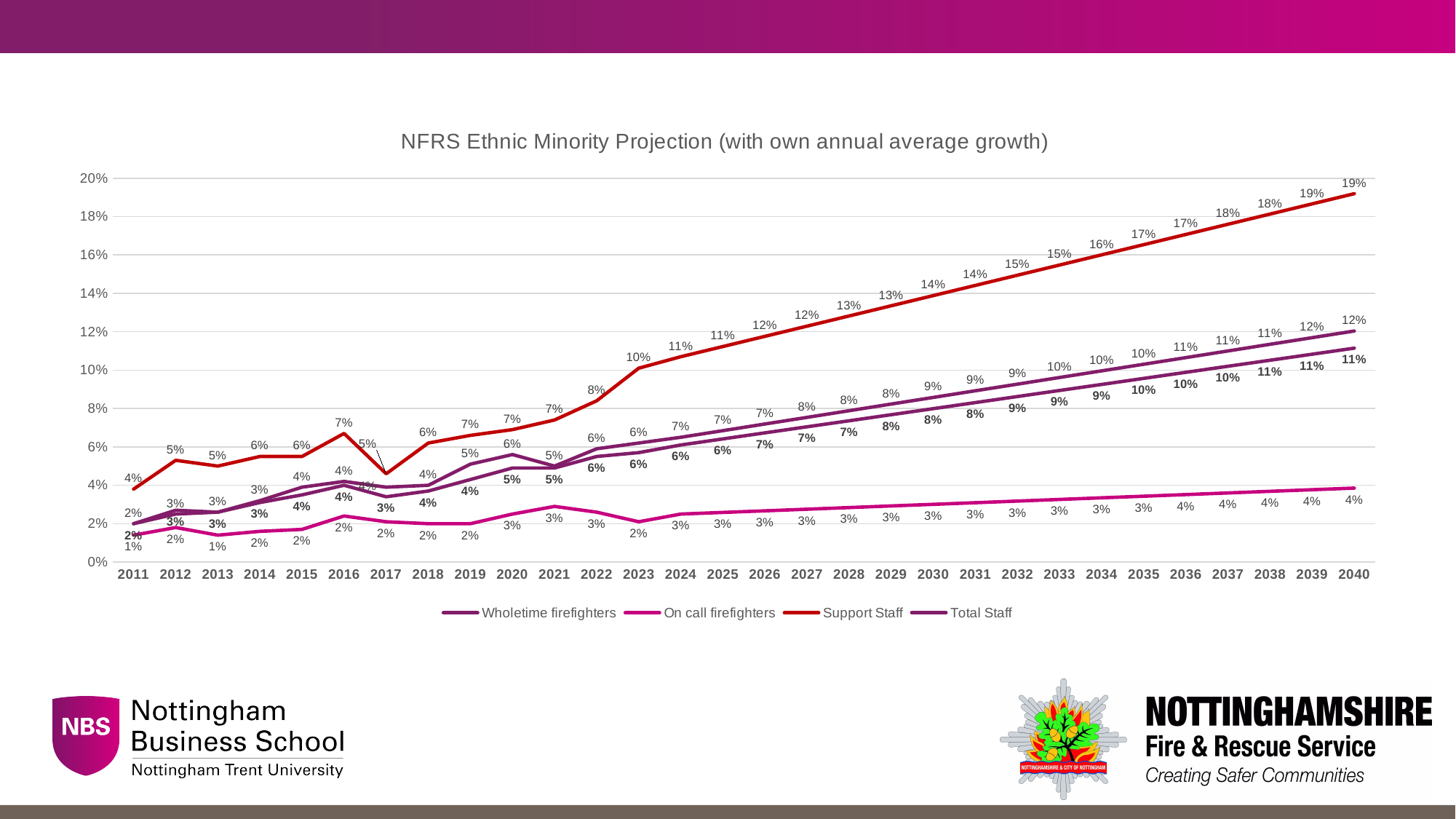
What is the difference between the Support Staff value and the On call firefighters value in 2040? 15 percentage points What is the value for On call firefighters in 2040? 4% What type of chart is shown on the slide? line chart Which series has the highest value in 2040? Support Staff What is the value for Support Staff in 2023? 10% How many series does the legend list? 4 What is the title of the chart? NFRS Ethnic Minority Projection (with own annual average growth) Which series has the lowest value in 2040? On call firefighters Is the Support Staff value larger in 2016 or in 2017? 2016 What is the value for On call firefighters in 2011? 1% How many years are shown along the x axis? 30 What is the projected value for Support Staff in 2040? 19%